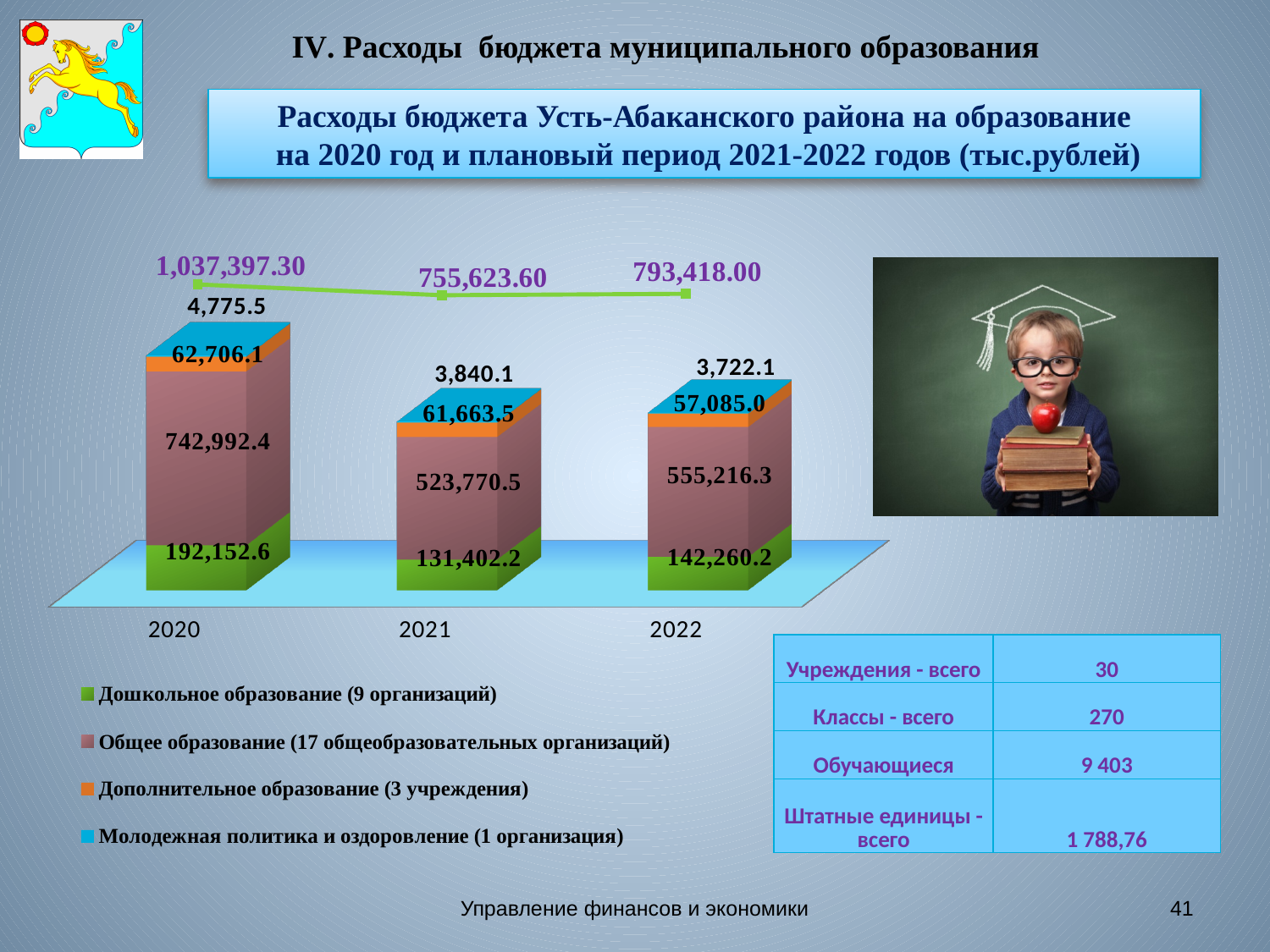
What is the value for Дошкольное образование in 2021? 131,402.2 In which year is the value for Общее образование the highest? 2020 What kind of chart is shown on the slide? Stacked bar chart How many years are shown on the x axis of the chart? 3 What is the difference between the Общее образование values for 2022 and 2021? 31,445.8 What is the value for Общее образование in 2020? 742,992.4 Which year has the larger value for Дошкольное образование, 2021 or 2022? 2022 In which year is the value for Дошкольное образование the lowest? 2021 What is the difference between the Дополнительное образование values for 2020 and 2022? 5,621.1 How many series does the legend list? 4 What is the value for Молодежная политика и оздоровление in 2022? 3,722.1 What value does the line series show for 2021? 755,623.60